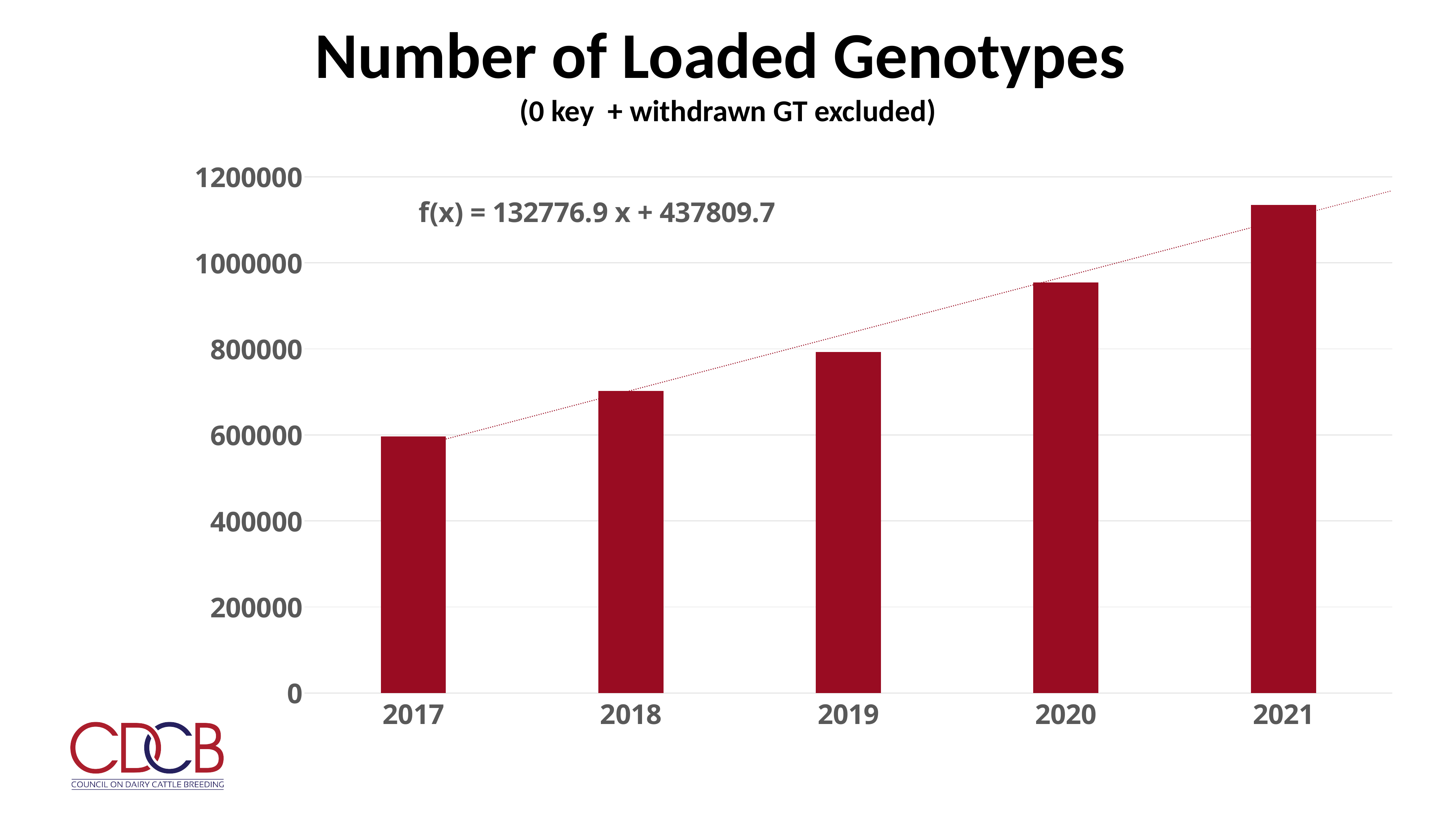
Which year has the highest number of loaded genotypes? 2021 Is the value for 2021 greater or less than 1000000? greater Is the value for 2017 greater or less than 400000? greater What is the trendline equation displayed on the chart? f(x) = 132776.9 x + 437809.7 What is the title of the chart? Number of Loaded Genotypes Is the value for 2020 greater or less than 1000000? less Do the number of loaded genotypes rise or fall from 2017 to 2021? rise How many years are shown on the x axis of the chart? 5 Which year has the lowest number of loaded genotypes? 2017 What kind of chart is shown on the slide? bar chart Which year has more loaded genotypes, 2018 or 2020? 2020